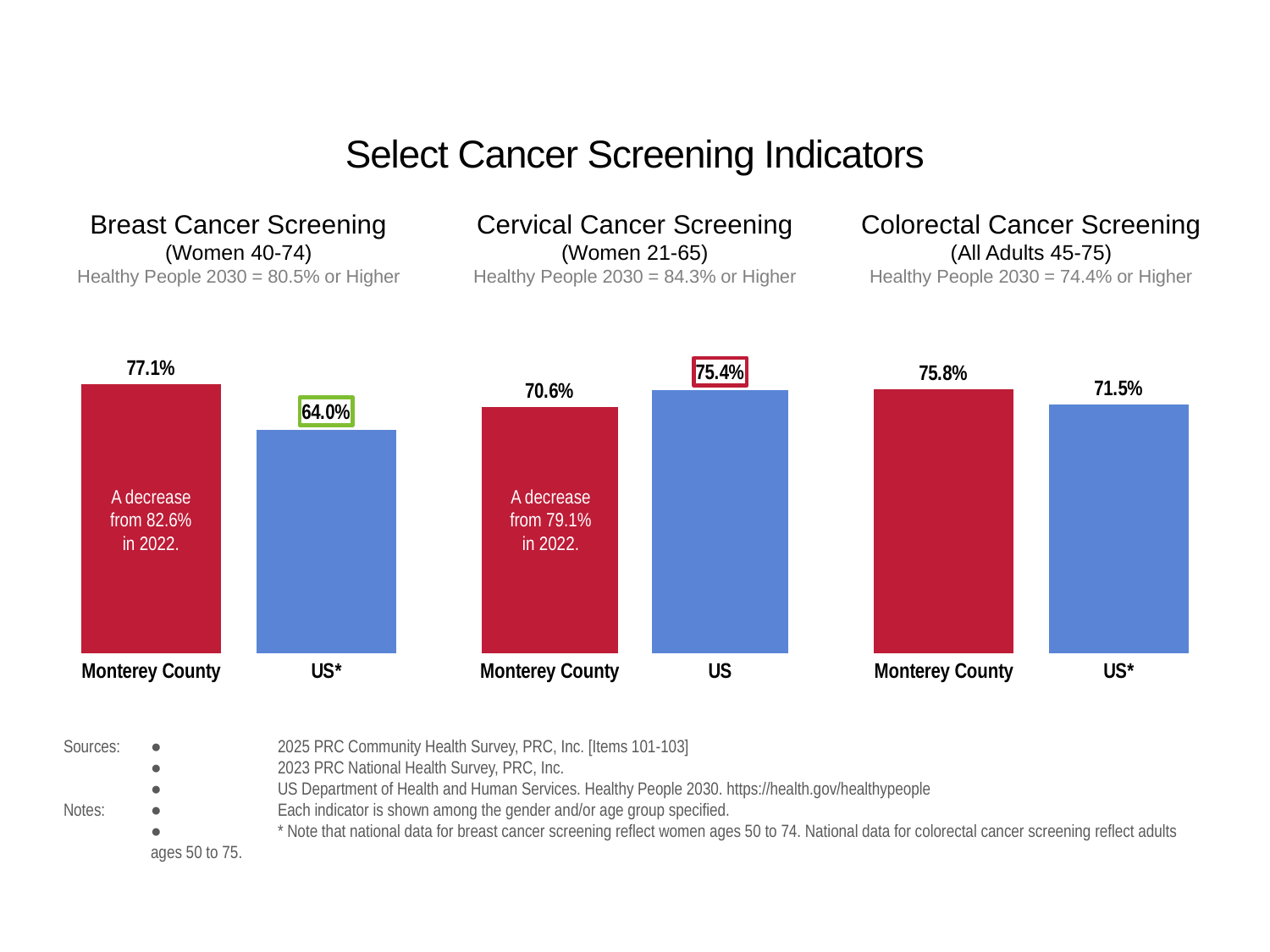
In the Breast Cancer Screening chart, what is the difference between the Monterey County and US* values? 13.1 percentage points In the Cervical Cancer Screening chart, what is the value for Monterey County? 70.6% In the Cervical Cancer Screening chart, which is larger, Monterey County or US? US In the Colorectal Cancer Screening chart, what is the value for US*? 71.5% How many bars are in the Cervical Cancer Screening chart? 2 In the Colorectal Cancer Screening chart, what is the difference between Monterey County and US*? 4.3 percentage points In the Colorectal Cancer Screening chart, which category has the highest value? Monterey County In the Breast Cancer Screening chart, what is the value for Monterey County? 77.1% According to the Breast Cancer Screening chart, what was the Monterey County value in 2022? 82.6% In the Breast Cancer Screening chart, what is the value for US*? 64.0% In the Cervical Cancer Screening chart, what is the value for US? 75.4% What type of chart is used for the Breast Cancer Screening indicator? Bar chart